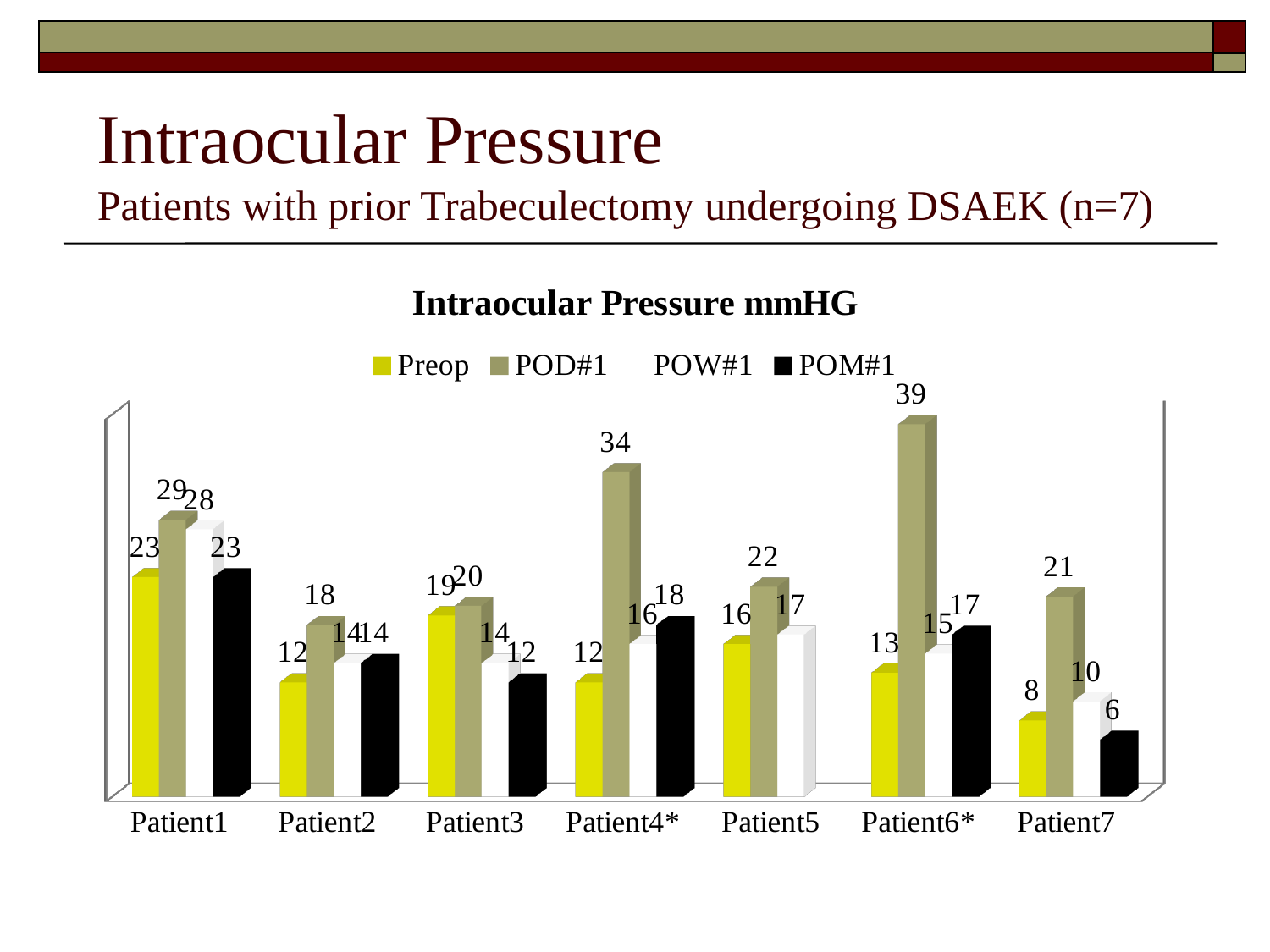
Which is larger, the Preop value for Patient1 or the Preop value for Patient3? Patient1 What is the POD#1 value for Patient6*? 39 How many patients are shown on the x axis? 7 Which patient has the highest Preop value? Patient1 Which patient has the lowest POM#1 value? Patient7 What is the Preop value for Patient7? 8 Which patient has the highest POD#1 value? Patient6* What is the POW#1 value for Patient1? 28 What kind of chart is shown on the slide? Bar chart What is the title of the chart? Intraocular Pressure mmHG How many series does the legend list? 4 What is the difference between the POD#1 and Preop values for Patient4*? 22